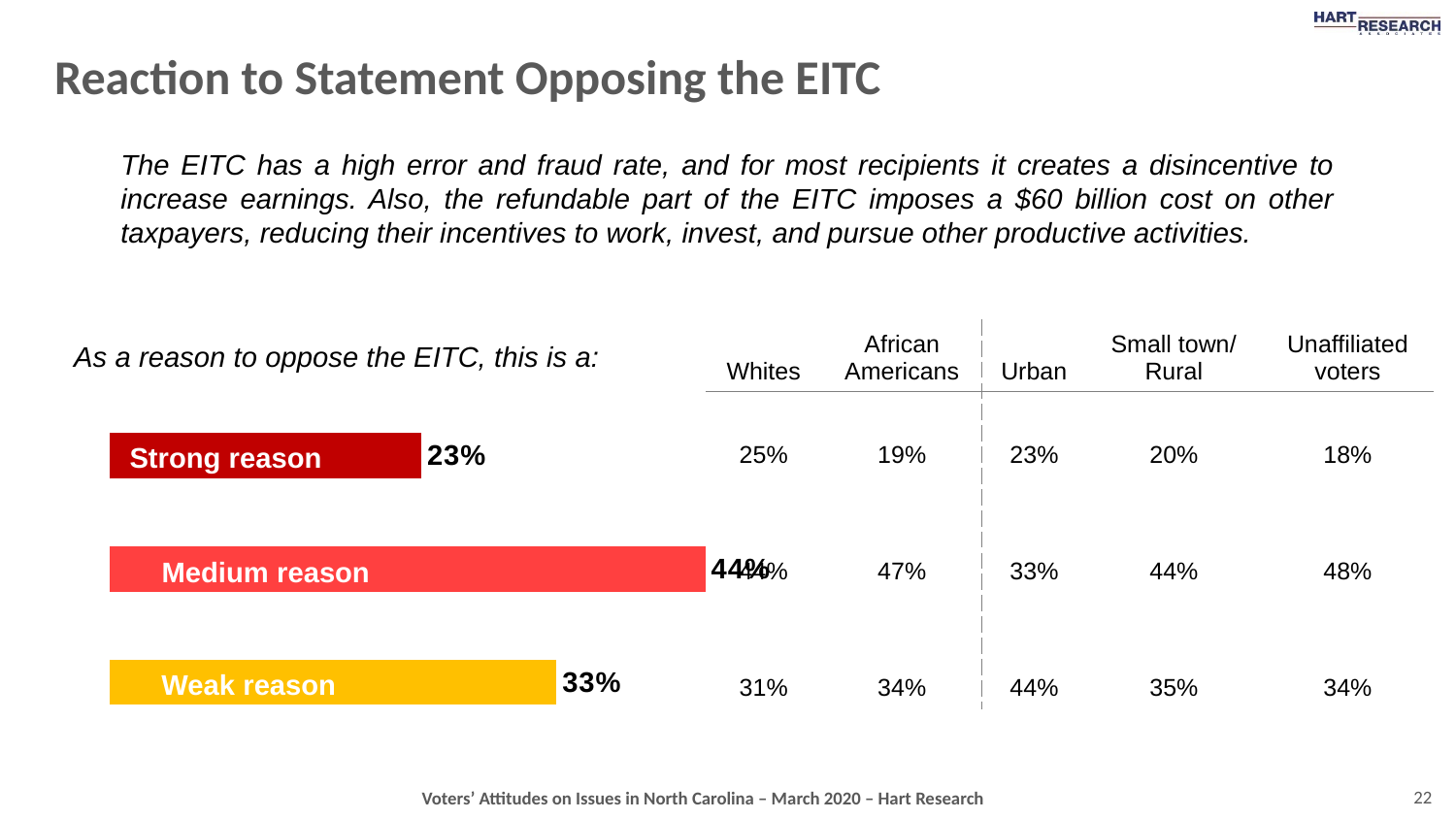
What kind of chart is shown on the slide? Bar chart What is the difference between the Medium reason and Strong reason values? 21 percentage points What value is shown for the Medium reason bar? 44% What colour is the Weak reason bar? Yellow What value is shown for the Weak reason bar? 33% How many categories are shown in the bar chart? 3 What is the difference between the Weak reason and Strong reason values? 10 percentage points Which category has the lowest value in the bar chart? Strong reason Which is larger, the Weak reason value or the Strong reason value? Weak reason Which category has the highest value in the bar chart? Medium reason What percentage of respondents said the statement is a strong reason to oppose the EITC? 23% What is the total of the three bar values in the chart? 100%